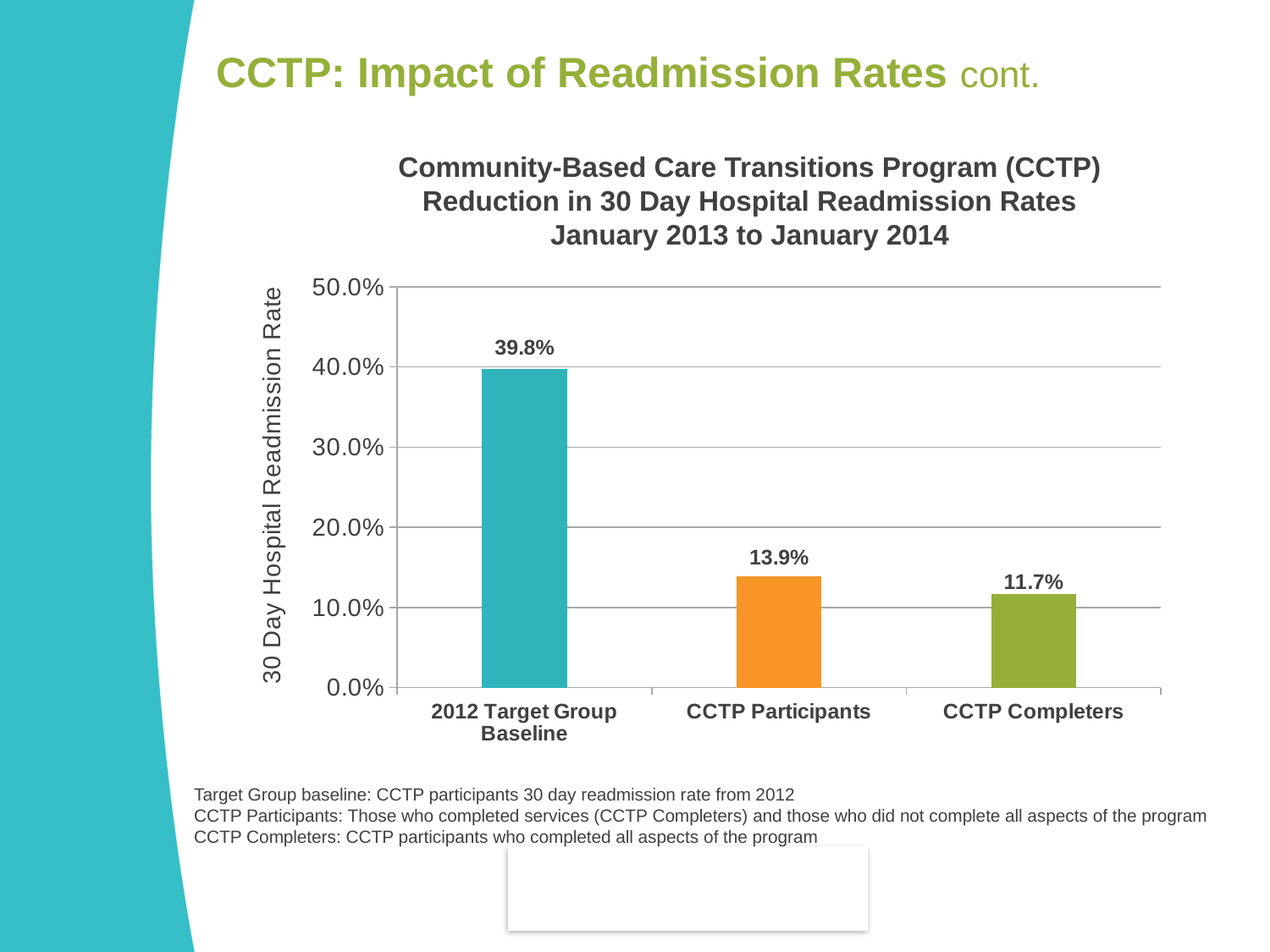
Which category has the highest readmission rate? 2012 Target Group Baseline What is the label of the vertical axis of the chart? 30 Day Hospital Readmission Rate What is the difference in readmission rate between CCTP Participants and CCTP Completers? 2.2% Which category has the lowest readmission rate? CCTP Completers Is the readmission rate for the 2012 Target Group Baseline greater or less than 30.0%? greater What is the 30 day hospital readmission rate for CCTP Completers? 11.7% Which has a higher readmission rate, CCTP Participants or CCTP Completers? CCTP Participants What kind of chart is shown on the slide? Bar chart How many categories are shown on the x axis of the chart? 3 What is the 30 day hospital readmission rate for CCTP Participants? 13.9% What is the 30 day hospital readmission rate for the 2012 Target Group Baseline? 39.8% What is the difference in readmission rate between the 2012 Target Group Baseline and CCTP Participants? 25.9%